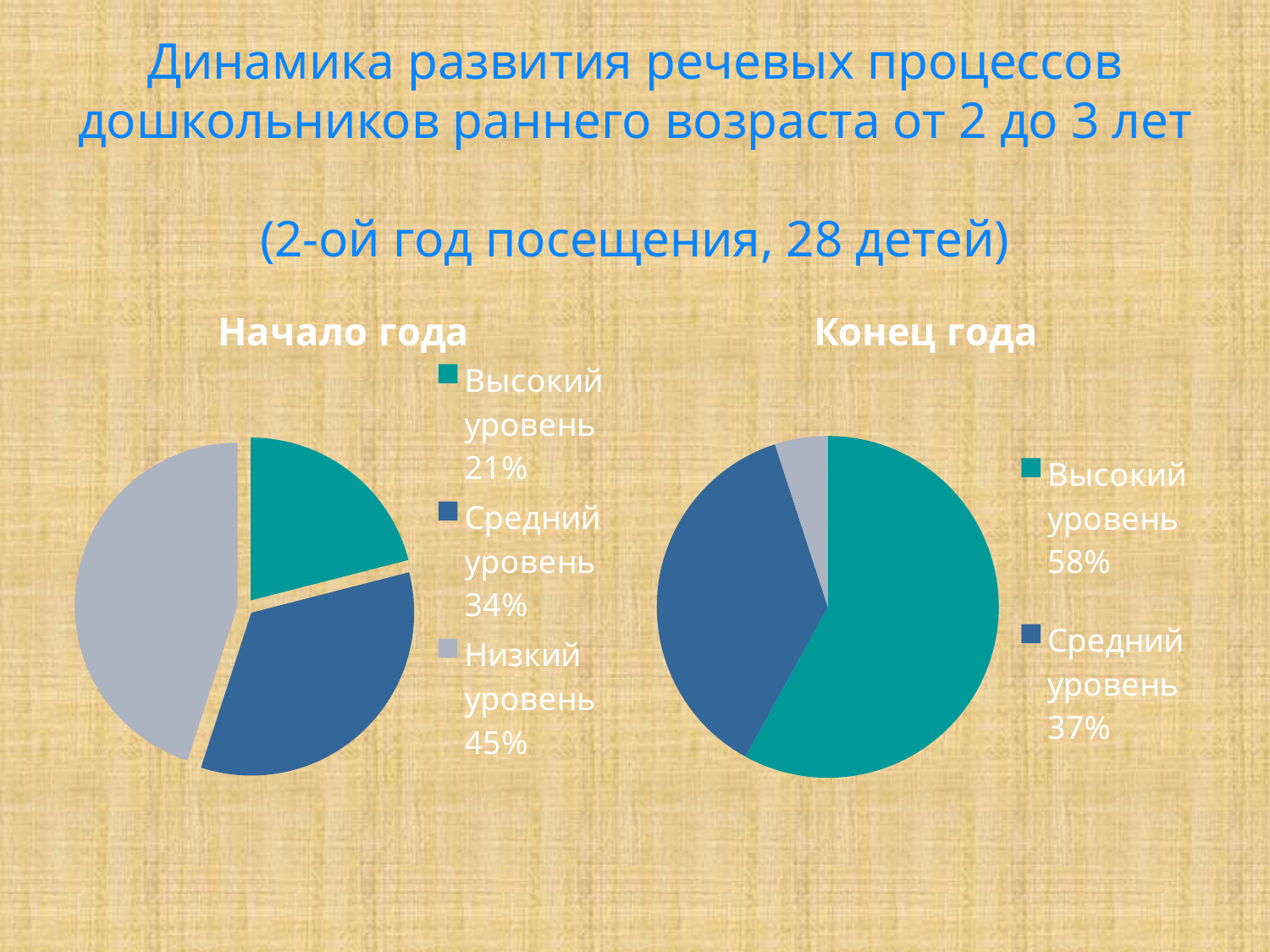
What kind of chart is the "Начало года" chart? Pie chart In the "Начало года" chart, which level has the largest slice? Низкий уровень In the "Начало года" chart, what is the difference between the shares of "Низкий уровень" and "Высокий уровень"? 24 percentage points In the "Начало года" chart, what share does "Средний уровень" have? 34% In the "Конец года" chart, which is larger: "Высокий уровень" or "Средний уровень"? Высокий уровень How many entries does the legend of the "Начало года" chart list? 3 In the "Начало года" chart, what share does "Низкий уровень" have? 45% In the "Конец года" chart, what share does "Средний уровень" have? 37% In the "Начало года" chart, which level has the smallest slice? Высокий уровень Comparing the two charts, by how many percentage points did the share of "Высокий уровень" change from "Начало года" to "Конец года"? 37 percentage points